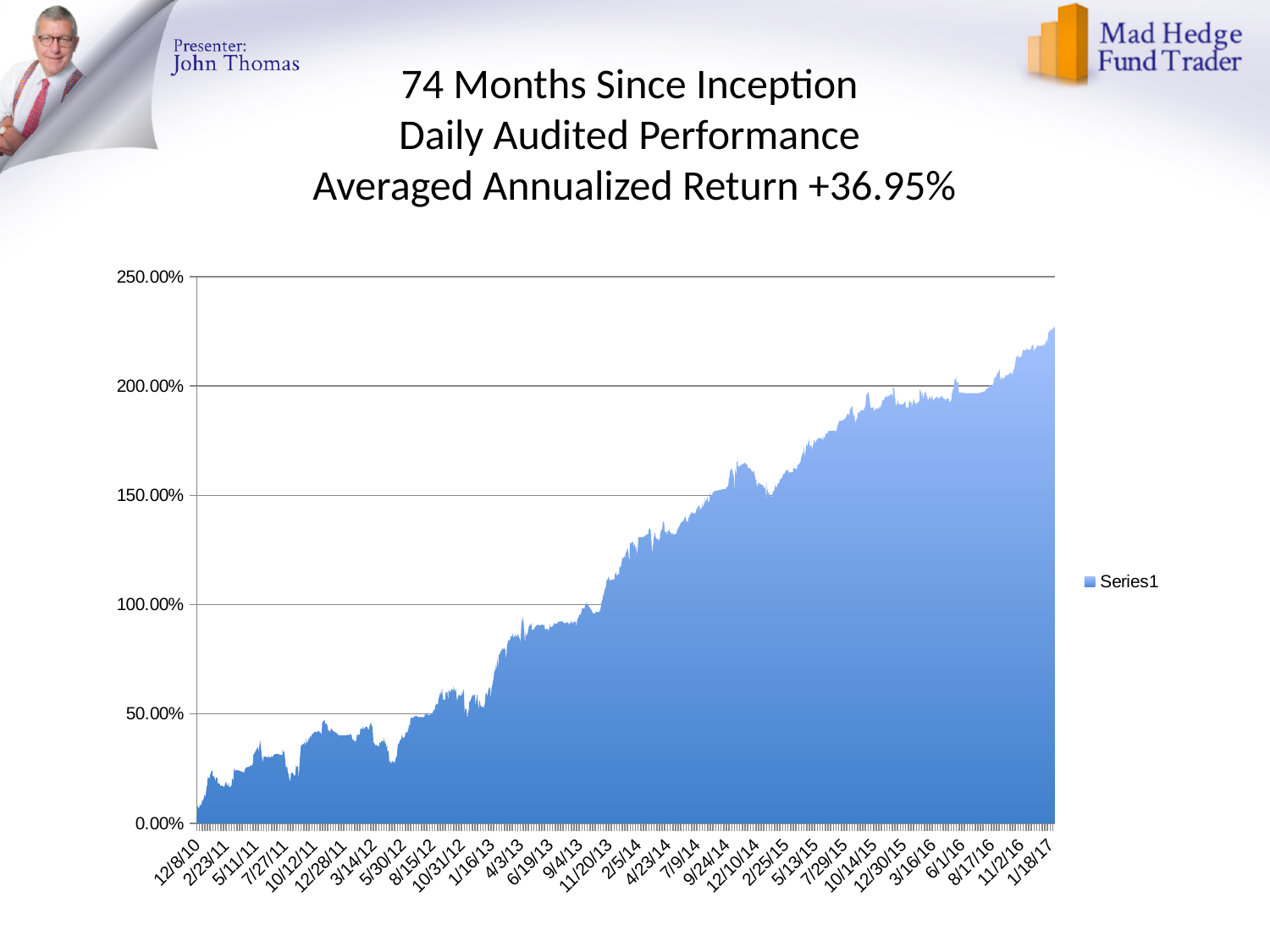
Is the value at 1/18/17 greater or less than 200.00%? greater Is the value at 5/30/12 greater or less than 50.00%? less Do the values generally rise or fall from 12/8/10 to 1/18/17? Rise How many series does the legend list? 1 Is the value at 4/3/13 greater or less than 100.00%? less Which is larger, the value at 1/18/17 or the value at 12/8/10? 1/18/17 What is the name of the series shown in the legend? Series1 What is the highest value shown on the y axis? 250.00% What kind of chart is shown on the slide? Area chart